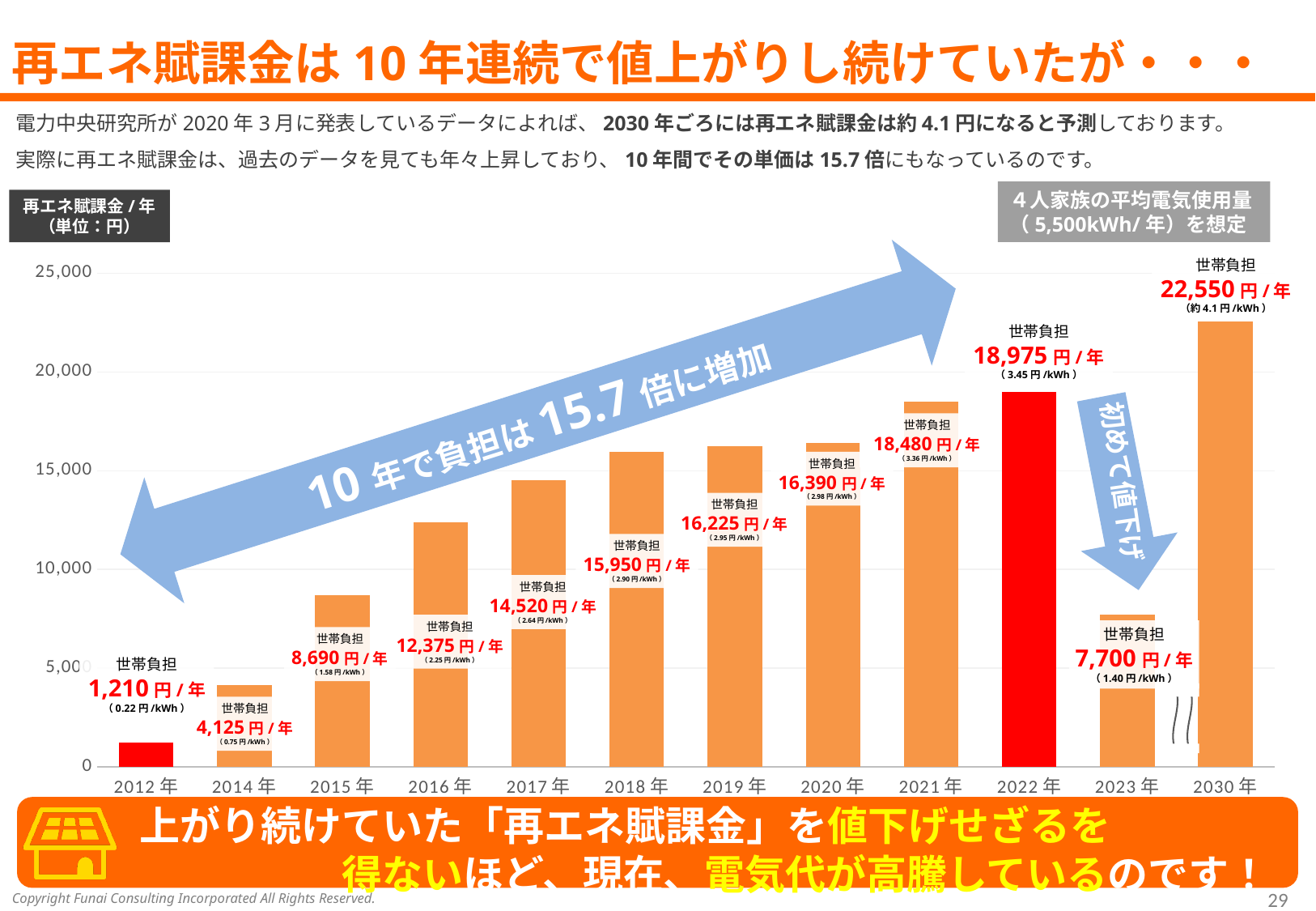
What is the 世帯負担 value for 2022 年? 18,975 円/年 How many years (bars) are plotted on the chart? 12 What colour is the bar for 2022 年? red Is the value for 2017 年 greater or less than 10,000? greater What is the difference between the 世帯負担 values for 2022 年 and 2023 年? 11,275 円/年 What kind of chart is shown on the slide? bar chart What is the 世帯負担 value for 2023 年? 7,700 円/年 Which is larger, the 世帯負担 value for 2021 年 or for 2020 年? 2021 年 What is the per-kWh rate shown for 2016 年? 2.25 円/kWh Do the 世帯負担 values rise or fall from 2012 年 through 2022 年? rise Which year has the highest 世帯負担 value on the chart? 2030 年 Which year has the lowest 世帯負担 value on the chart? 2012 年